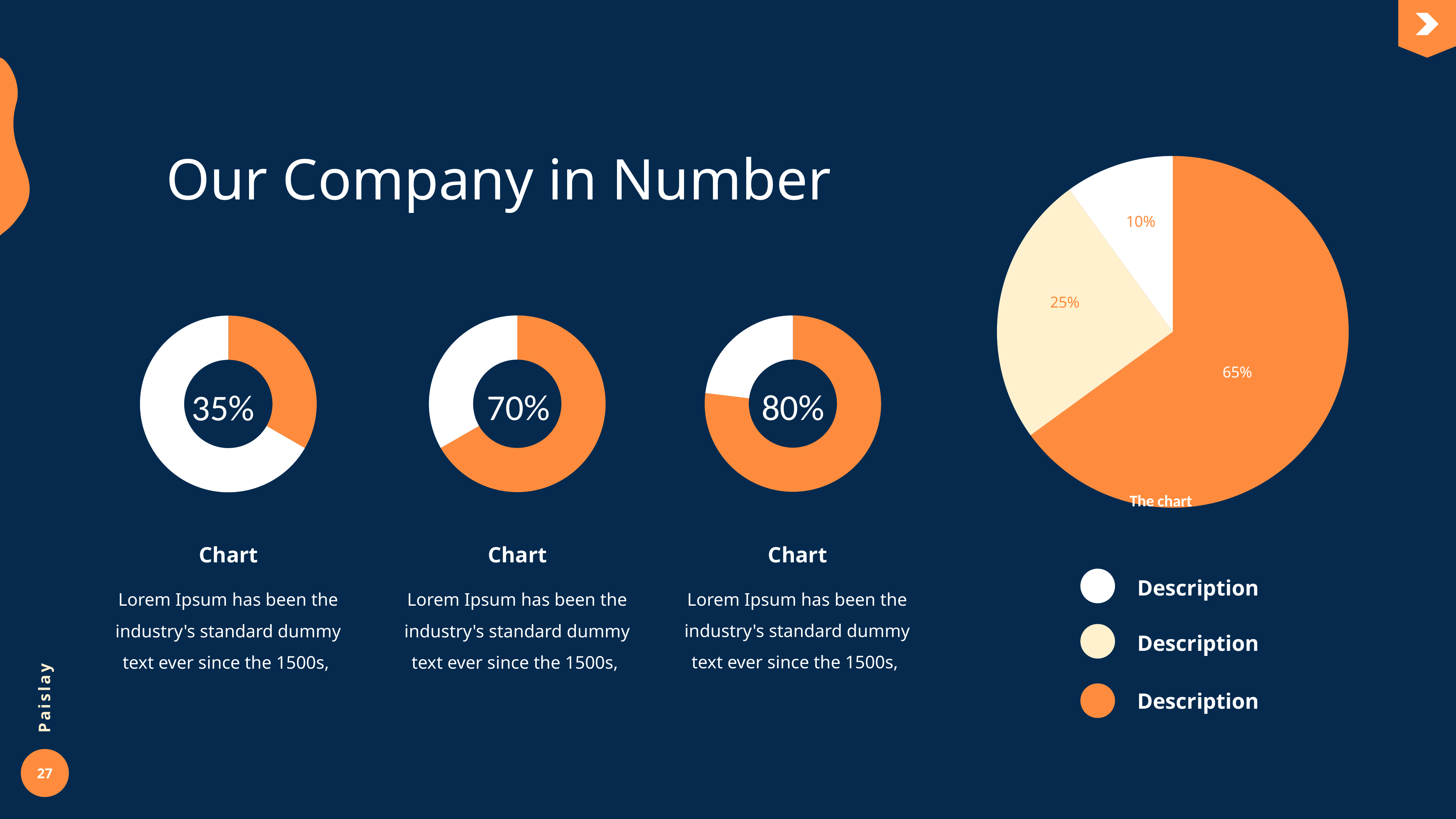
What percentage is shown in the centre of the middle donut chart? 70% What percentage is shown in the centre of the rightmost donut chart? 80% How many entries does the legend below the pie chart "The chart" list? 3 In the pie chart titled "The chart", what colour is the 65% slice? Orange In the pie chart titled "The chart", what is the difference between the 65% slice and the 25% slice? 40 percentage points In the pie chart titled "The chart", what is the value of the smallest slice? 10% In the pie chart titled "The chart", what is the value of the largest slice? 65% What percentage is shown in the centre of the leftmost donut chart? 35% Of the three donut charts, which one shows the highest percentage? The rightmost (80%) What kind of chart is the large chart on the right side of the slide? Pie chart How many slices does the pie chart titled "The chart" have? 3 Of the three donut charts, which one shows the lowest percentage? The leftmost (35%)